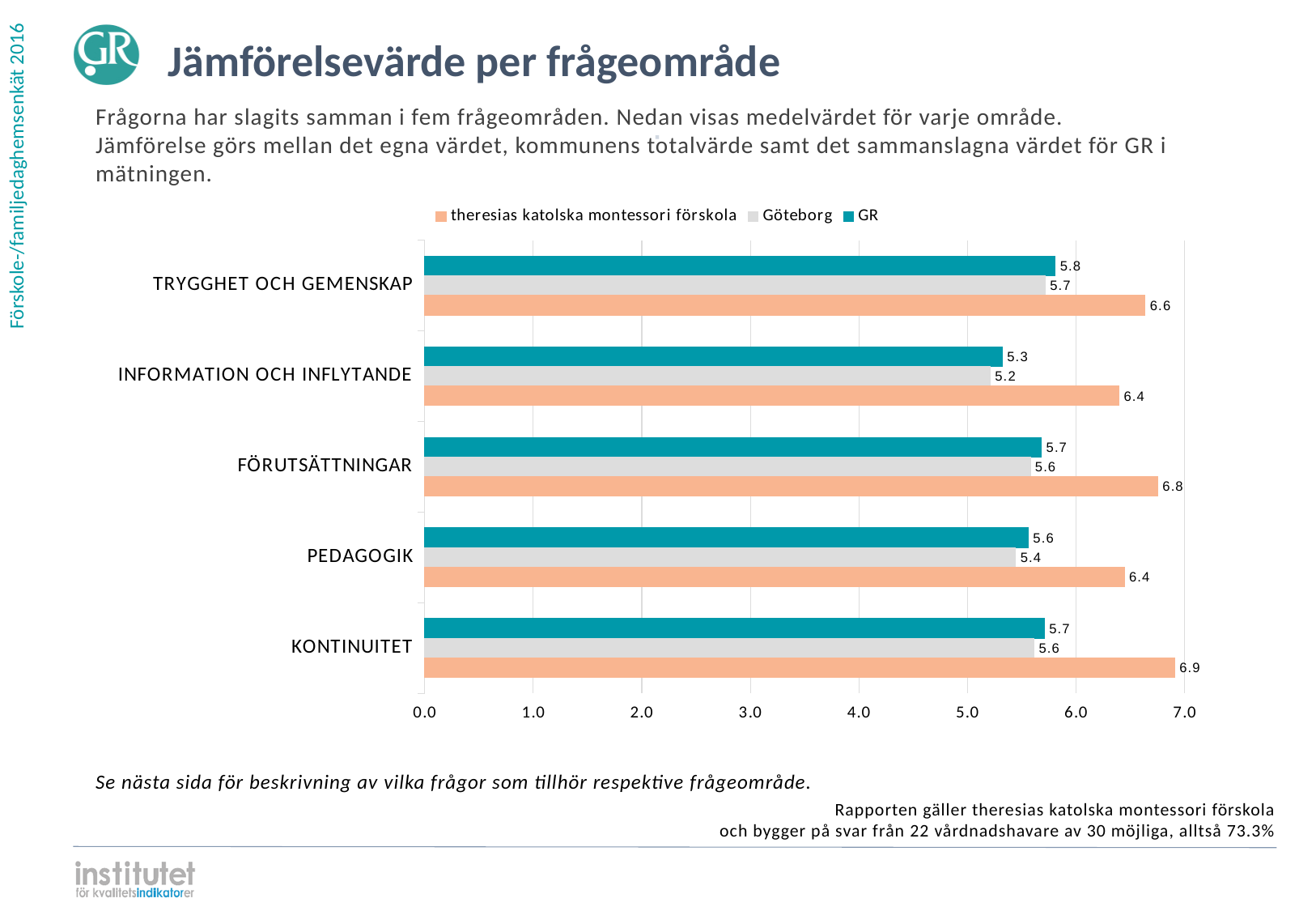
What is the value for GR in INFORMATION OCH INFLYTANDE? 5.3 Is the value for GR in PEDAGOGIK greater or less than 6.0? less What is the difference between the theresias katolska montessori förskola value and the Göteborg value in FÖRUTSÄTTNINGAR? 1.2 How many series does the legend list? 3 Which series is shown in orange in the legend? theresias katolska montessori förskola Which is larger in TRYGGHET OCH GEMENSKAP: the value for GR or the value for theresias katolska montessori förskola? theresias katolska montessori förskola What kind of chart is shown on the slide? bar chart What is the value for Göteborg in PEDAGOGIK? 5.4 How many question areas (categories) are shown on the chart? 5 In which category does theresias katolska montessori förskola have its highest value? KONTINUITET In which category does Göteborg have its lowest value? INFORMATION OCH INFLYTANDE What is the value for theresias katolska montessori förskola in KONTINUITET? 6.9